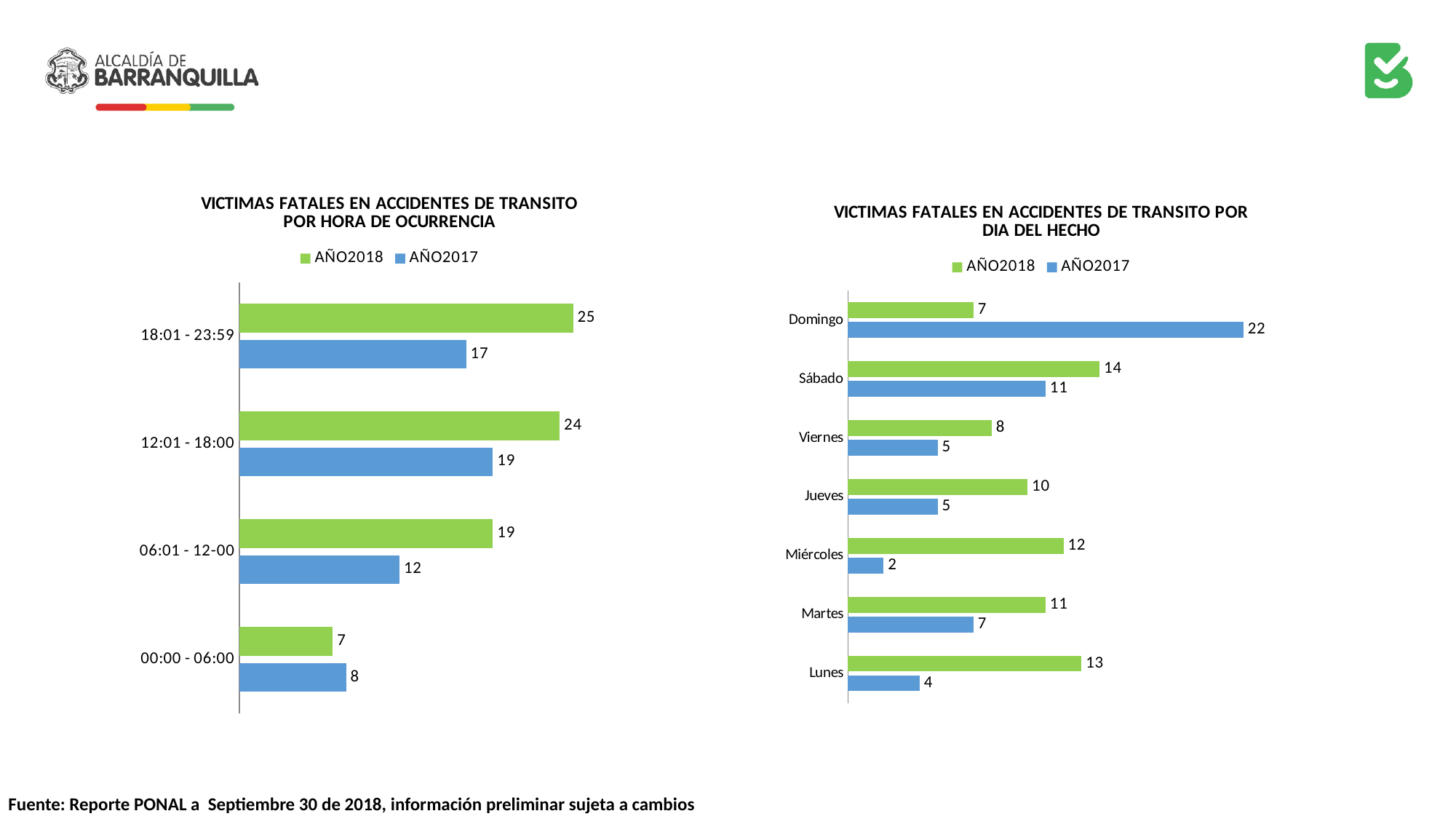
How many series does the legend of the chart 'VICTIMAS FATALES EN ACCIDENTES DE TRANSITO POR DIA DEL HECHO' list? 2 In the chart 'VICTIMAS FATALES EN ACCIDENTES DE TRANSITO POR DIA DEL HECHO', which day has the lowest AÑO2017 value? Miércoles In the chart 'VICTIMAS FATALES EN ACCIDENTES DE TRANSITO POR DIA DEL HECHO', which is larger for Lunes, the AÑO2018 value or the AÑO2017 value? AÑO2018 In the chart 'VICTIMAS FATALES EN ACCIDENTES DE TRANSITO POR HORA DE OCURRENCIA', which time range has the lowest AÑO2018 value? 00:00 - 06:00 What kind of chart is 'VICTIMAS FATALES EN ACCIDENTES DE TRANSITO POR HORA DE OCURRENCIA'? Bar chart In the chart 'VICTIMAS FATALES EN ACCIDENTES DE TRANSITO POR HORA DE OCURRENCIA', what is the AÑO2017 value for 06:01 - 12-00? 12 In the chart 'VICTIMAS FATALES EN ACCIDENTES DE TRANSITO POR HORA DE OCURRENCIA', what is the AÑO2018 value for 18:01 - 23:59? 25 In the chart 'VICTIMAS FATALES EN ACCIDENTES DE TRANSITO POR HORA DE OCURRENCIA', what is the difference between the AÑO2018 and AÑO2017 values for 12:01 - 18:00? 5 In the chart 'VICTIMAS FATALES EN ACCIDENTES DE TRANSITO POR HORA DE OCURRENCIA', how many time ranges are shown? 4 In the chart 'VICTIMAS FATALES EN ACCIDENTES DE TRANSITO POR DIA DEL HECHO', what is the difference between the AÑO2017 and AÑO2018 values for Domingo? 15 In the chart 'VICTIMAS FATALES EN ACCIDENTES DE TRANSITO POR DIA DEL HECHO', what is the AÑO2017 value for Domingo? 22 In the chart 'VICTIMAS FATALES EN ACCIDENTES DE TRANSITO POR DIA DEL HECHO', which day has the highest AÑO2018 value? Sábado